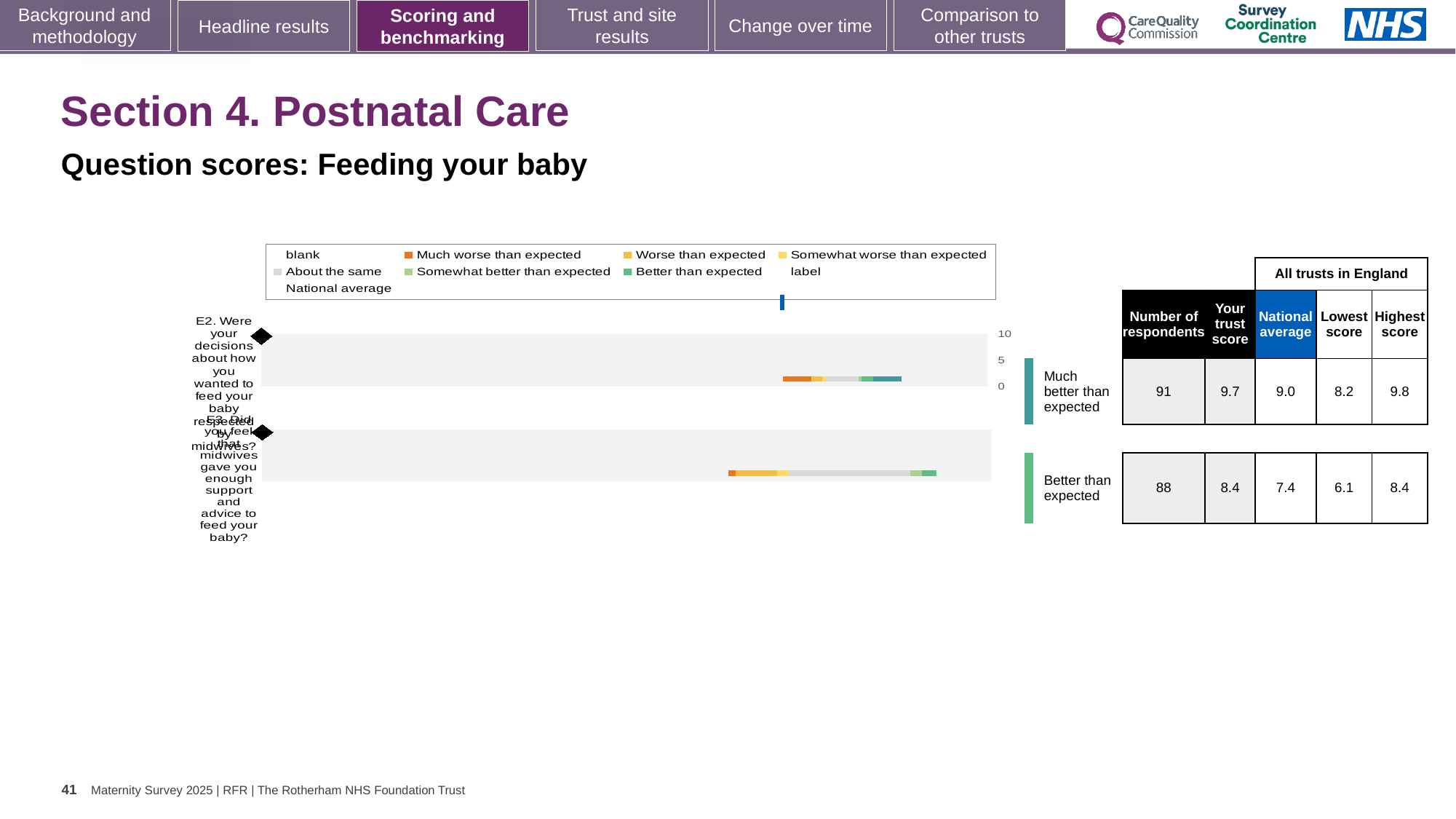
By how much does the trust score for E3 exceed the national average for E3? 1.0 What is the trust score for E2 (decisions about how you wanted to feed your baby respected by midwives)? 9.7 What kind of chart is used to show the question scores for Feeding your baby? bar chart What is the national average score for E2? 9.0 How many questions are plotted in the Feeding your baby chart? 2 By how much does the trust score for E2 exceed the national average for E2? 0.7 Which benchmark category is E2 placed in? Much better than expected Is the trust score for E2 greater or less than 5 on the chart axis? greater Which question has the higher trust score, E2 or E3? E2 What is the lowest score among all trusts in England for E3? 6.1 How many respondents answered question E3? 88 What is the trust score for E3 (midwives gave you enough support and advice to feed your baby)? 8.4